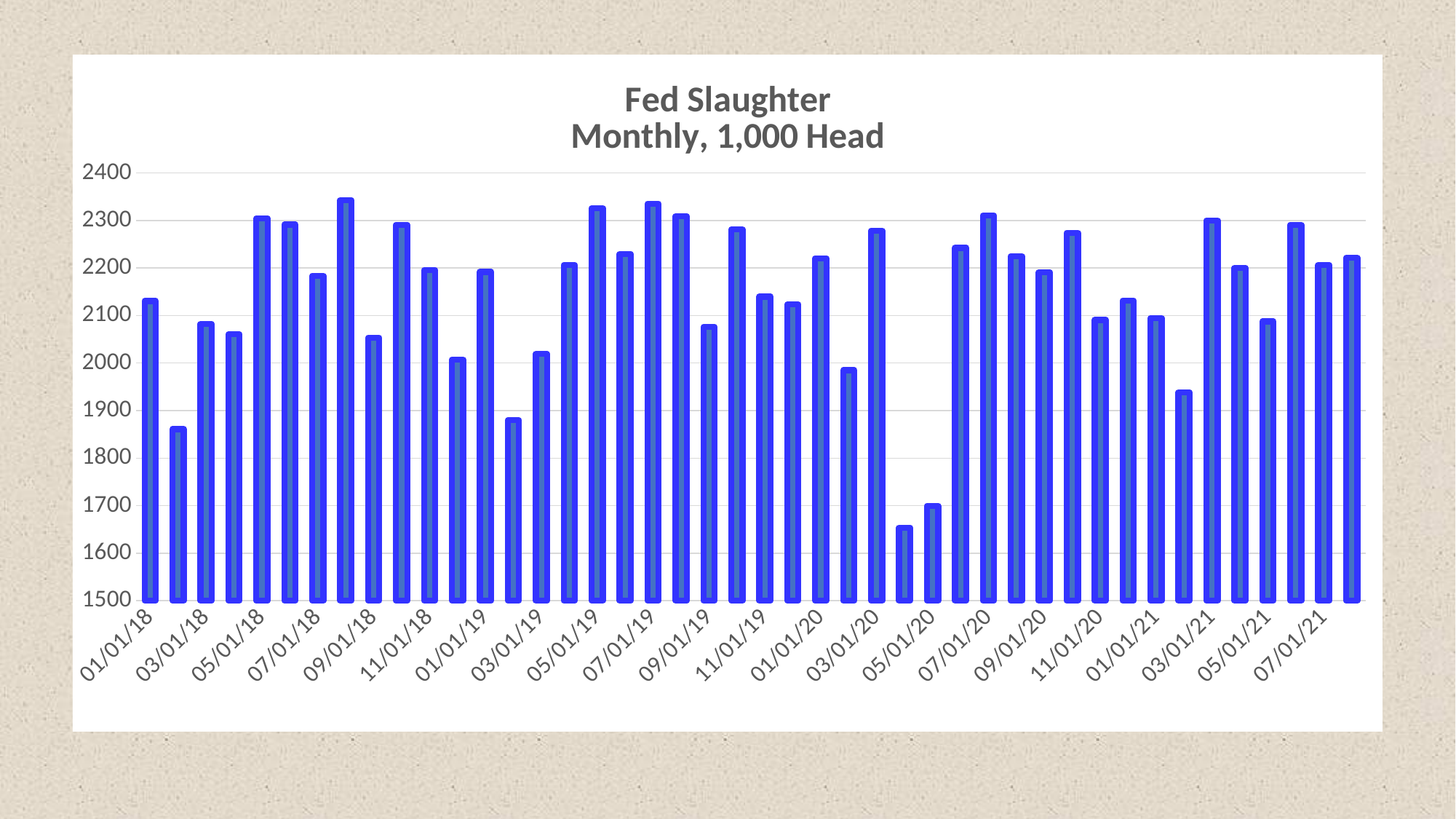
Is the value for 03/01/20 greater or less than 2000? greater Is the value for 09/01/18 greater or less than 2300? less Is the value for 01/01/18 greater or less than 2100? greater What is the title of the chart? Fed Slaughter Monthly, 1,000 Head What kind of chart is shown on the slide? bar chart Which is larger, the value for 05/01/20 or the value for 07/01/20? 07/01/20 Which is larger, the value for 03/01/18 or the value for 05/01/18? 05/01/18 What is the highest value shown on the vertical axis? 2400